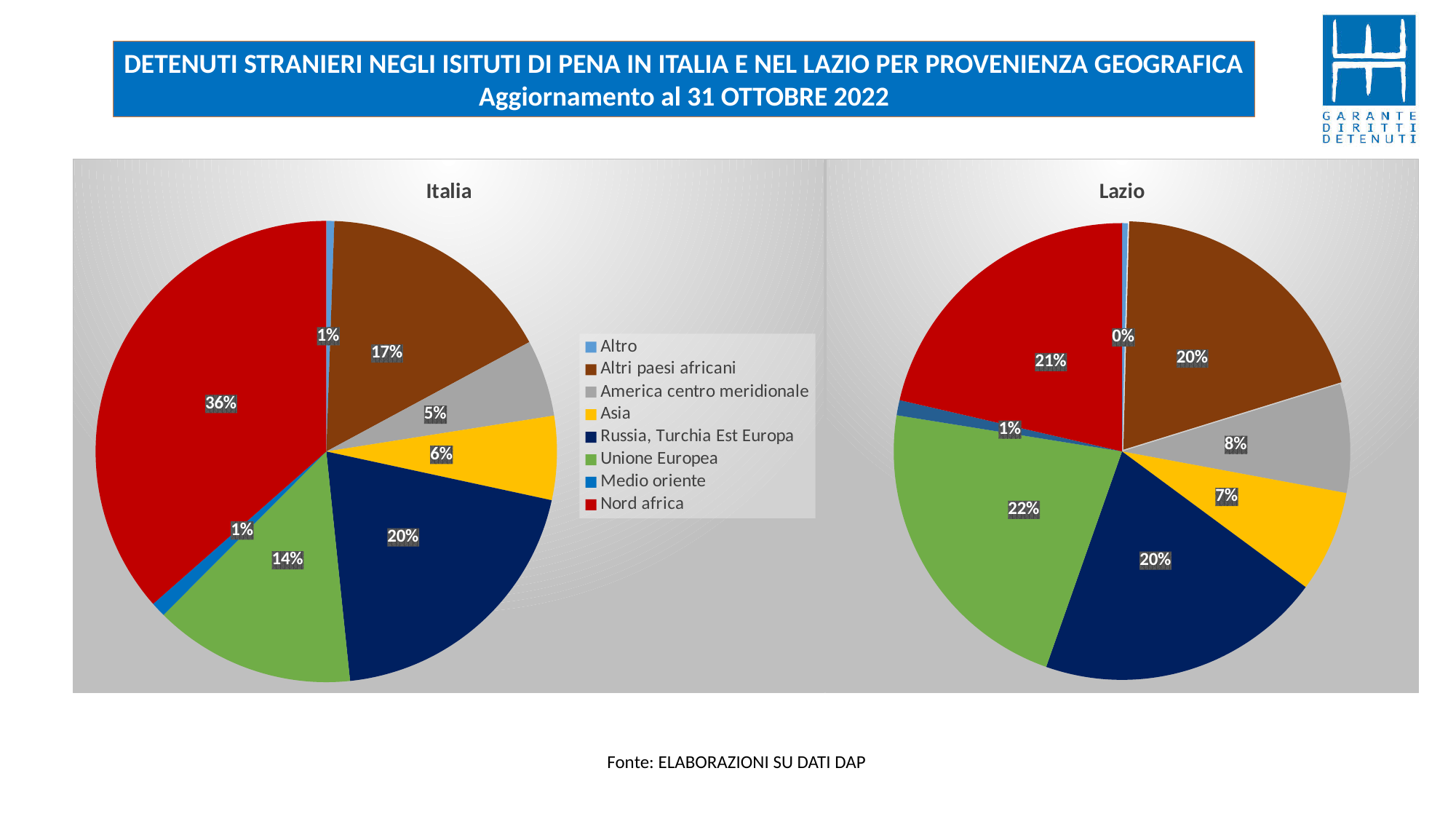
What type of chart is used for Italia and Lazio? Pie chart In the Lazio pie chart, which category has the largest share? Unione Europea In the Italia pie chart, what is the difference between the Nord africa share and the Russia, Turchia Est Europa share? 16% What colour represents Nord africa in the pie charts? Red In the Italia pie chart, what share is Altri paesi africani? 17% In the Italia pie chart, which category has the largest share? Nord africa How many categories does the legend list for the pie charts? 8 In the Lazio pie chart, which category has the smallest share? Altro In the Italia pie chart, what share is Nord africa? 36% In the Lazio pie chart, what share is Unione Europea? 22% Which is larger in the Italia pie chart: Unione Europea or Asia? Unione Europea In the Lazio pie chart, what share is America centro meridionale? 8%